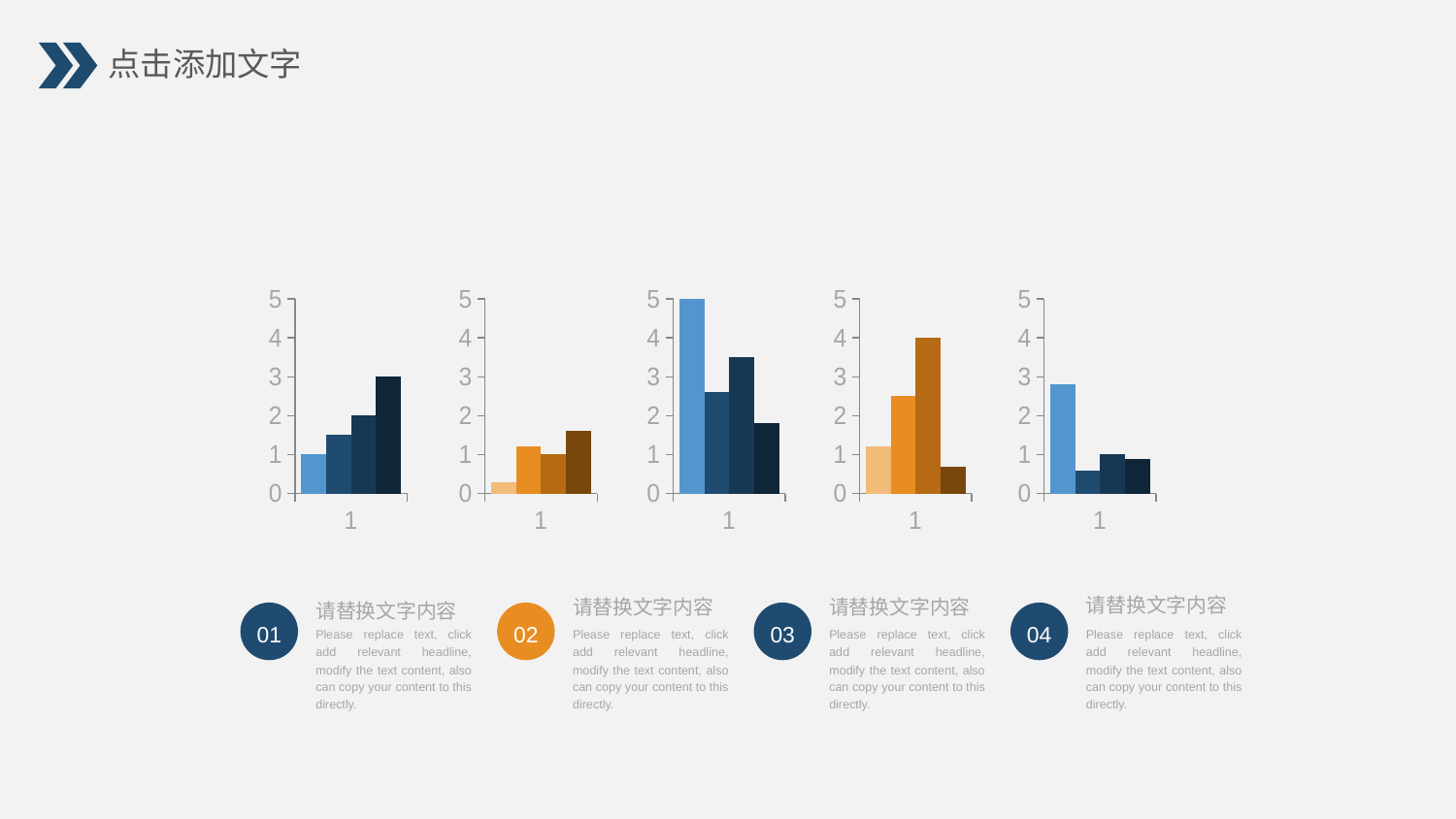
In the middle (third) chart, which bar is the tallest? the first (leftmost) bar In the second chart from the left, is the tallest bar greater or less than 2? less In the rightmost chart, is the first (leftmost) bar greater or less than 2? greater In the leftmost chart, do the bars rise or fall from left to right? rise In the leftmost chart, what value does the tallest bar reach? 3 What kind of chart is the leftmost chart on the slide? bar chart In the rightmost chart, is the second bar greater or less than 1? less What is the maximum value shown on the vertical axis of each chart? 5 In the leftmost chart, how many bars are plotted? 4 In the middle (third) chart, what value does the tallest bar reach? 5 How many charts are shown on the slide? 5 In the fourth chart from the left, what value does the tallest bar reach? 4